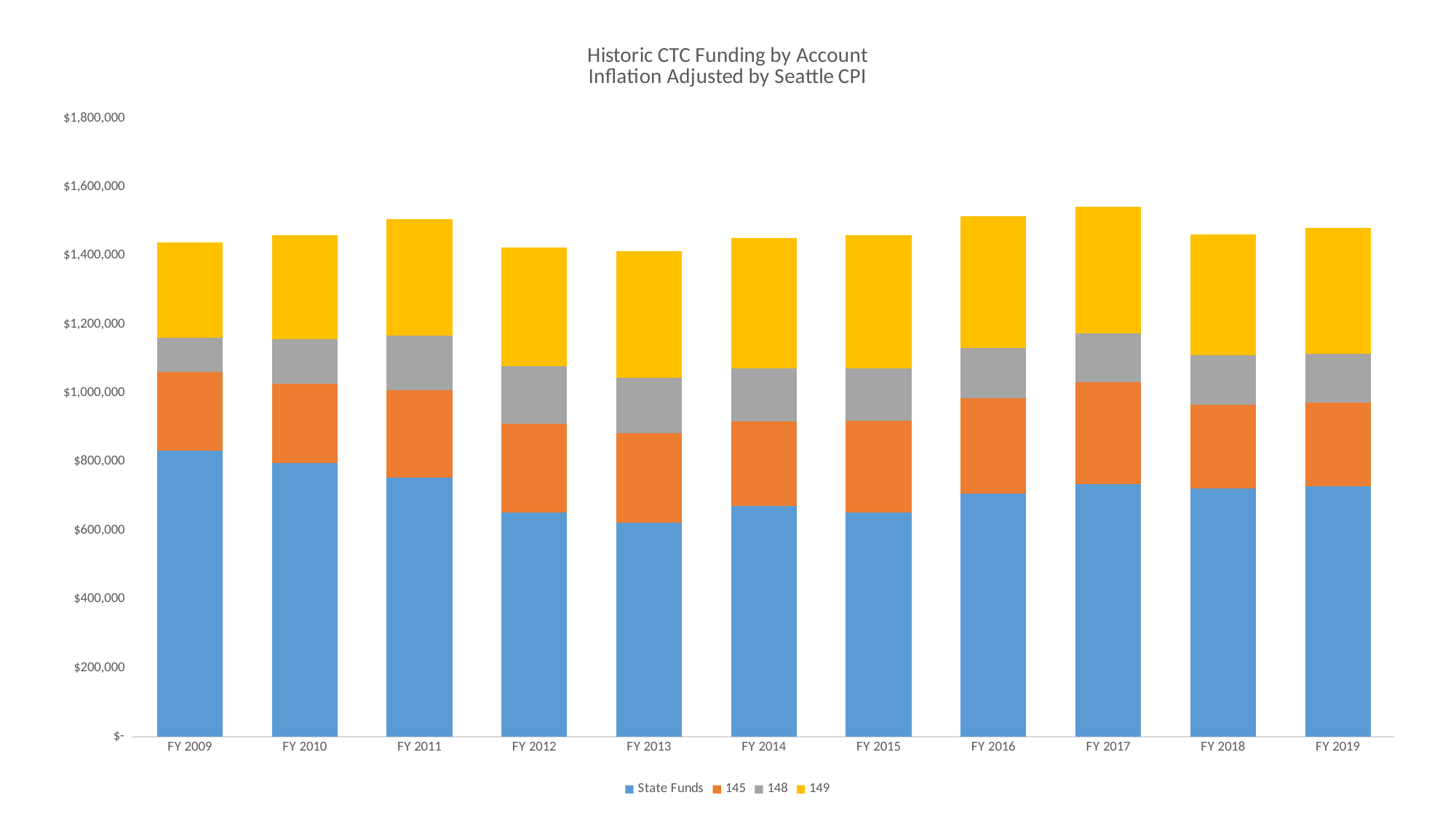
Which fiscal year has the largest State Funds segment? FY 2009 Is the State Funds value for FY 2009 greater or less than $800,000? greater Is the total stacked bar for FY 2017 greater or less than $1,400,000? greater What kind of chart is shown on the slide? Stacked bar chart How many fiscal years are shown on the x axis? 11 Which fiscal year has the smallest State Funds segment? FY 2013 Which series is shown in yellow in the legend? 149 Does the State Funds segment rise or fall from FY 2009 to FY 2013? Fall How many series does the legend list? 4 Which is larger, the State Funds segment for FY 2009 or for FY 2013? FY 2009 Which fiscal year has the tallest total stacked bar? FY 2017 Is the State Funds value for FY 2013 greater or less than $800,000? less